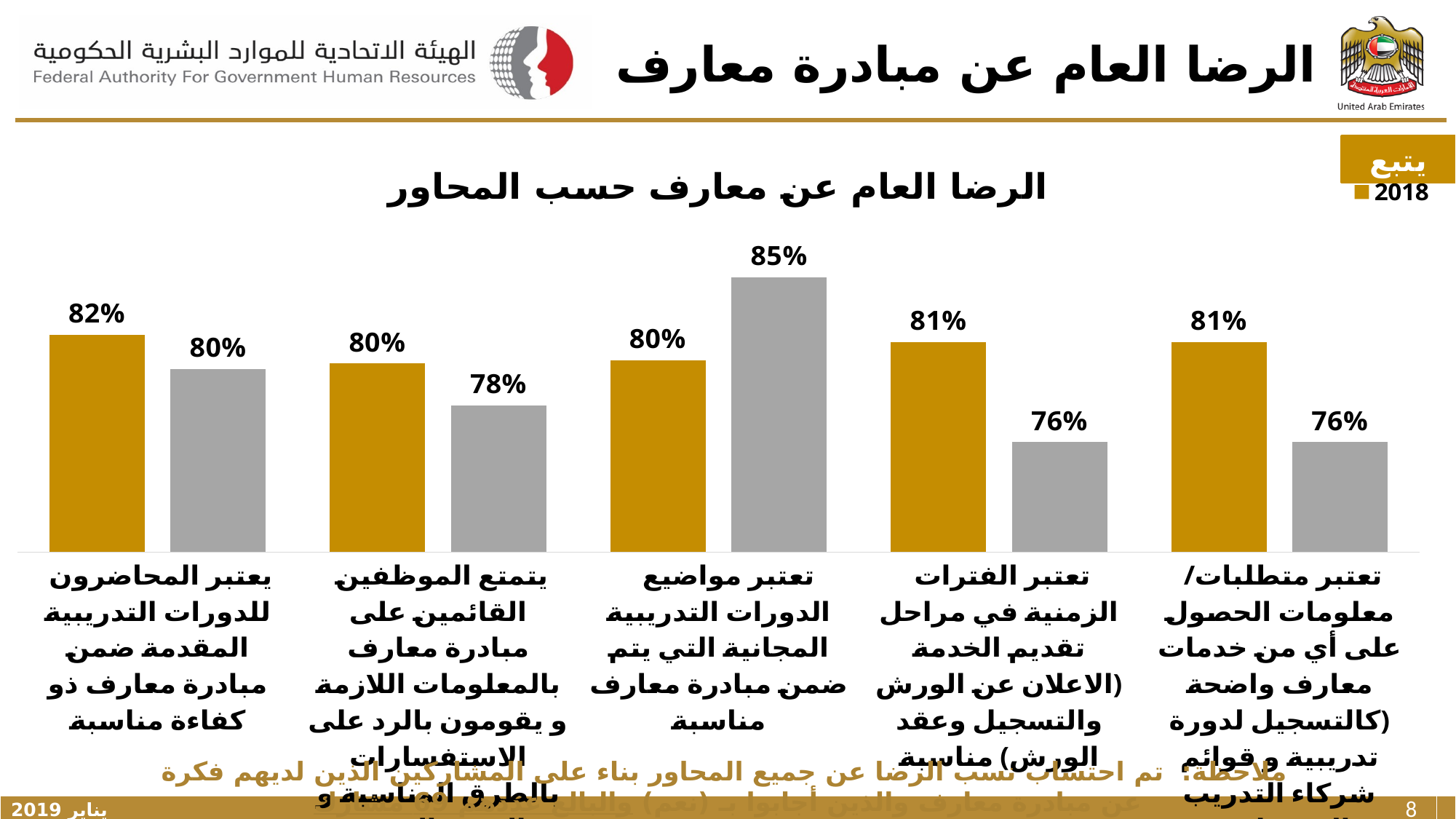
How many series does the legend list? 1 What type of chart is shown on the slide? bar chart How many categories are shown on the x axis? 5 What is the gold-bar value for the category 'يعتبر المحاضرون للدورات التدريبية المقدمة ضمن مبادرة معارف ذو كفاءة مناسبة'? 82% What is the title of the chart? الرضا العام عن معارف حسب المحاور Which category has the highest gold-bar value? يعتبر المحاضرون للدورات التدريبية المقدمة ضمن مبادرة معارف ذو كفاءة مناسبة